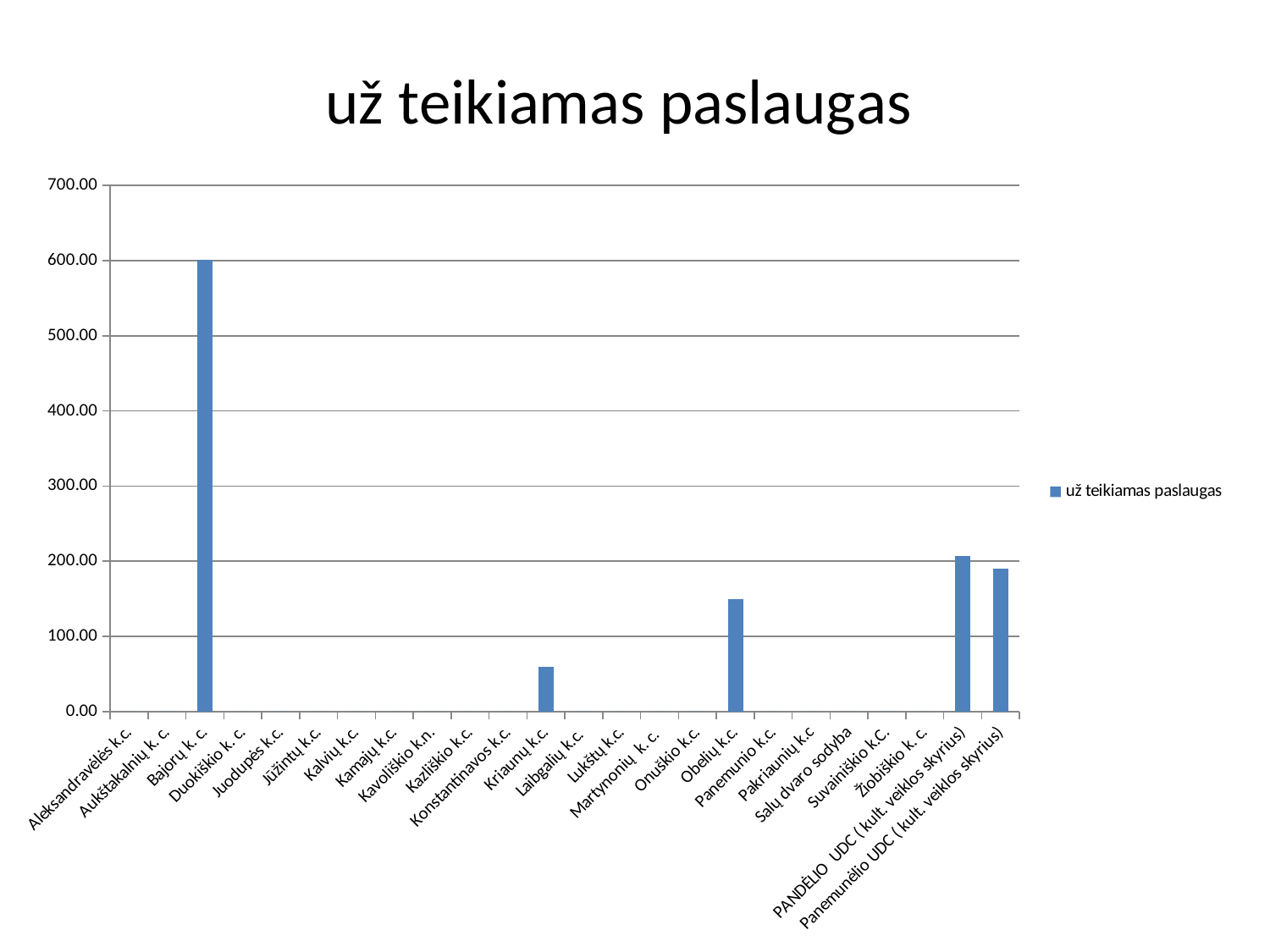
What kind of chart is shown on the slide? bar chart How many categories are shown on the x axis? 24 Is the value for Obelių k.c. greater or less than 100? greater How many series does the legend list? 1 Is the value for PANDĖLIO UDC ( kult. veiklos skyrius) greater or less than 200? greater Which category has the highest value? Bajorų k. c. Is the value for Kriaunų k.c. greater or less than 100? less What is the title of the chart? už teikiamas paslaugas Which is larger, the value for Obelių k.c. or the value for Kriaunų k.c.? Obelių k.c.